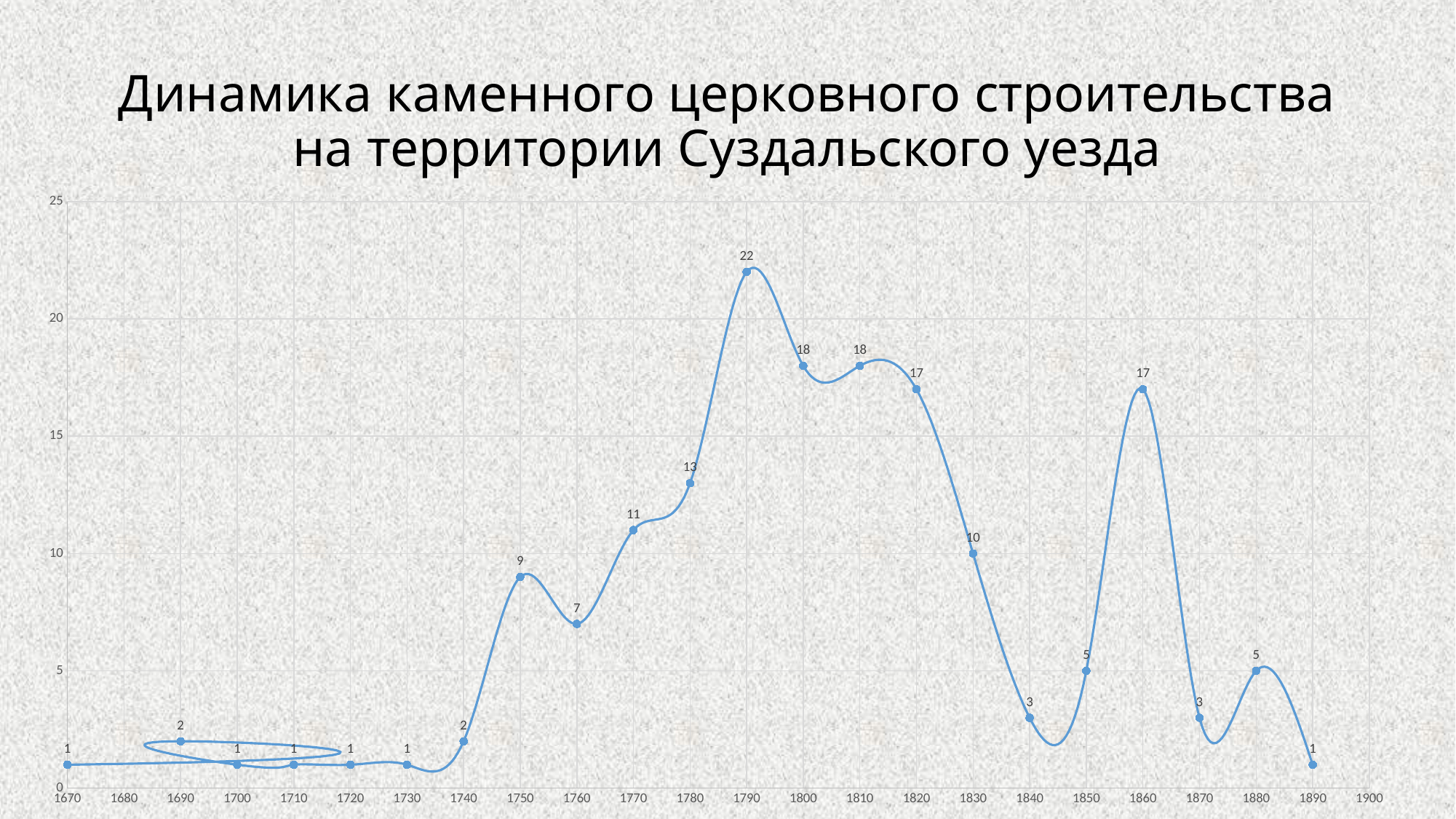
What is the difference between the values for 1860 and 1870? 14 Which is larger, the value for 1840 or the value for 1850? 1850 Do the values rise or fall from 1790 to 1840? fall Which is larger, the value for 1780 or the value for 1770? 1780 What is the value for 1830? 10 What kind of chart is shown on the slide? line chart What is the difference between the values for 1790 and 1800? 4 What is the value for 1790? 22 What is the value for 1860? 17 Which year has the highest value? 1790 What is the title of the chart? Динамика каменного церковного строительства на территории Суздальского уезда What is the value for 1750? 9